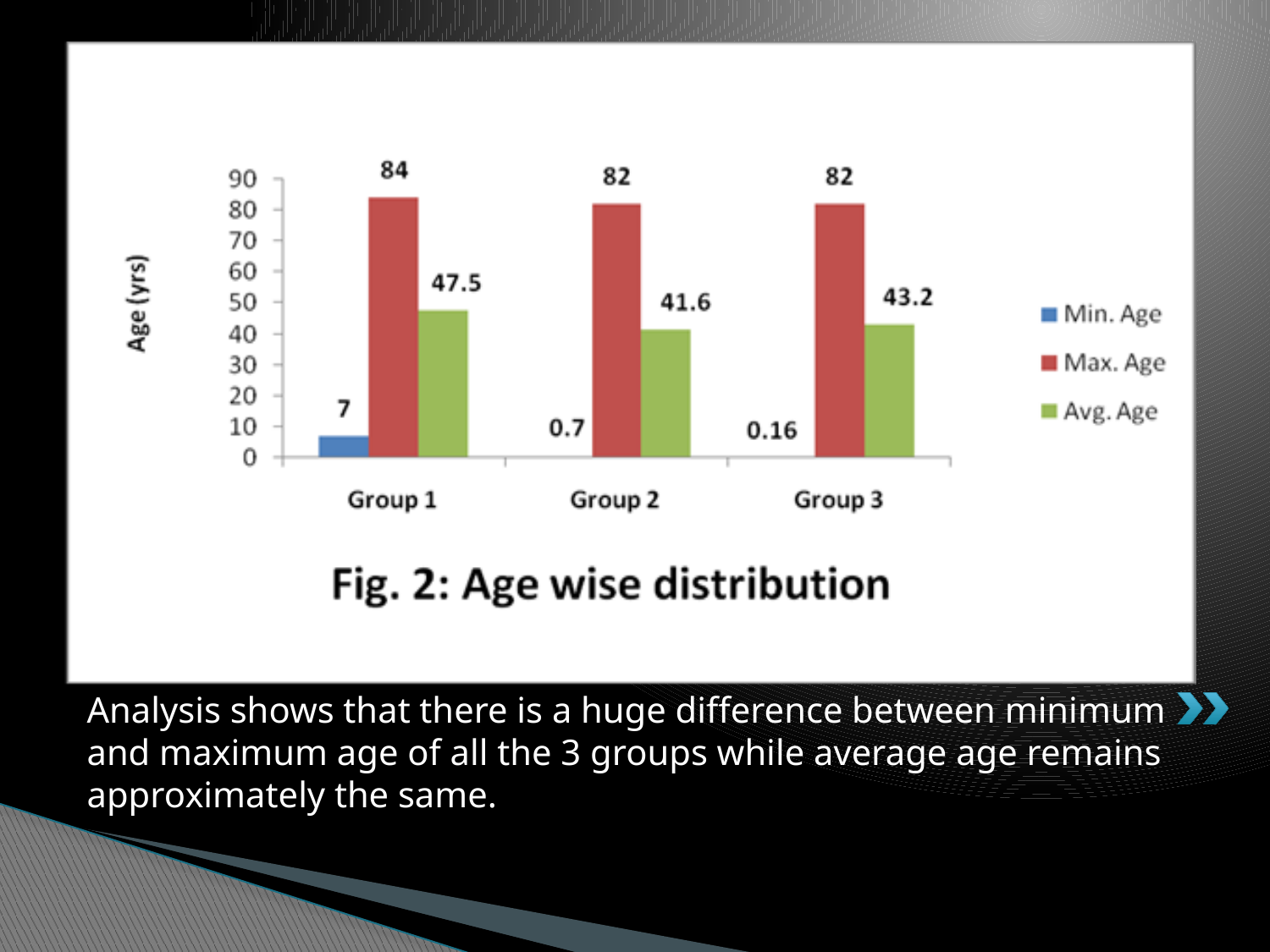
Is the Avg. Age value for Group 1 greater or less than 40? greater What is the difference between the Max. Age of Group 1 and the Max. Age of Group 2? 2 What is the Max. Age value for Group 1? 84 What is the Min. Age value for Group 3? 0.16 How many groups are shown on the x axis? 3 What is the Avg. Age value for Group 2? 41.6 How many series does the legend list? 3 Which is larger, the Avg. Age of Group 3 or the Avg. Age of Group 2? Avg. Age of Group 3 What is the title of the figure? Fig. 2: Age wise distribution Which group has the highest Avg. Age? Group 1 Which group has the lowest Min. Age? Group 3 What kind of chart is shown? Bar chart